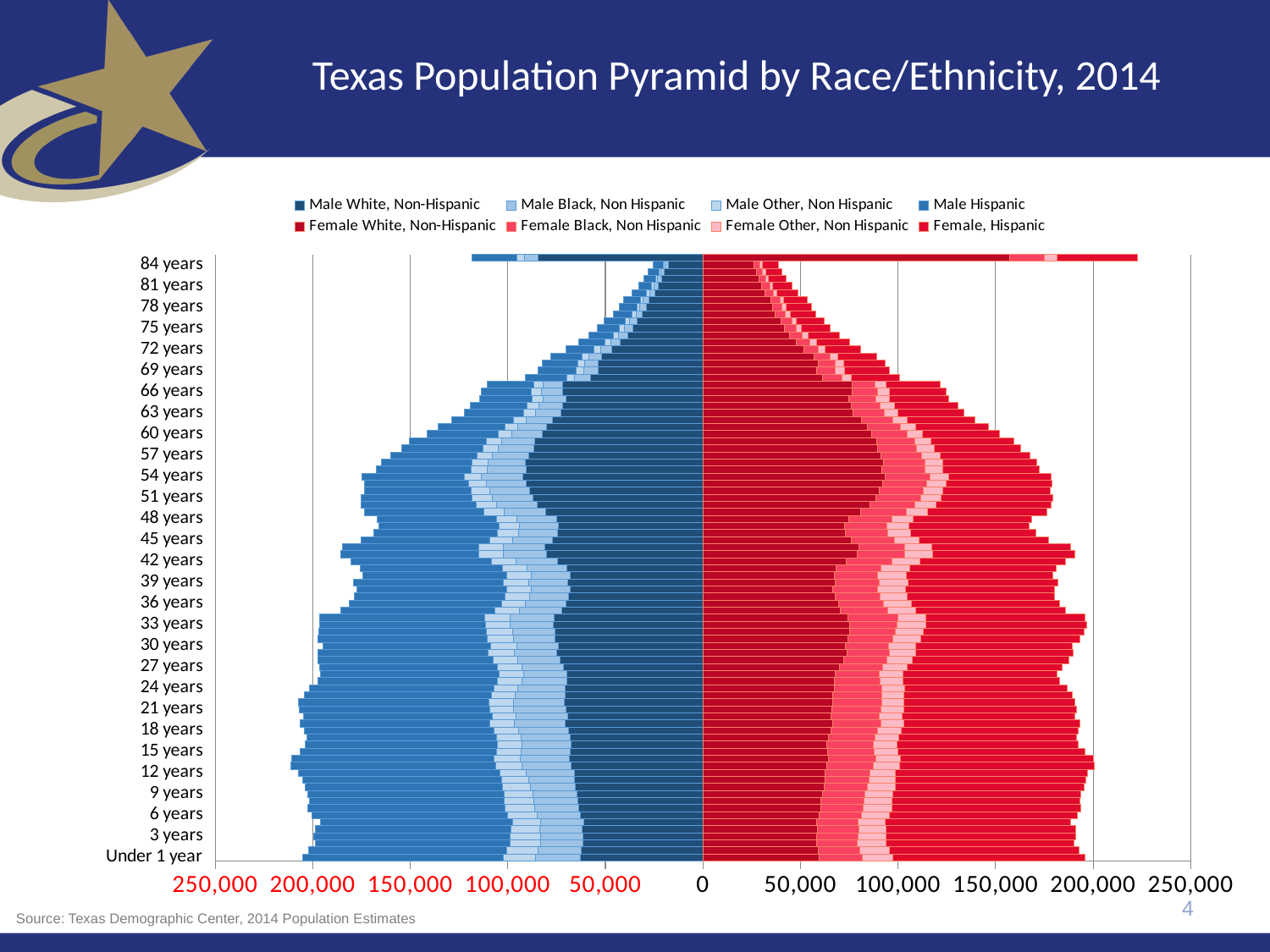
What is the title of the chart? Texas Population Pyramid by Race/Ethnicity, 2014 What kind of chart is shown on the slide? bar chart Is the total male bar for 81 years greater or less than 50,000? less Is the total male bar for 60 years greater or less than 100,000? greater Which is larger, the total male bar for 12 years or the total male bar for 81 years? 12 years Is the Male White, Non-Hispanic segment for 54 years greater or less than 50,000? greater How many series does the legend list? 8 Moving from 42 years up to 81 years, do the total male bars generally get shorter or longer? shorter Which legend entry is shown in the darkest blue colour? Male White, Non-Hispanic